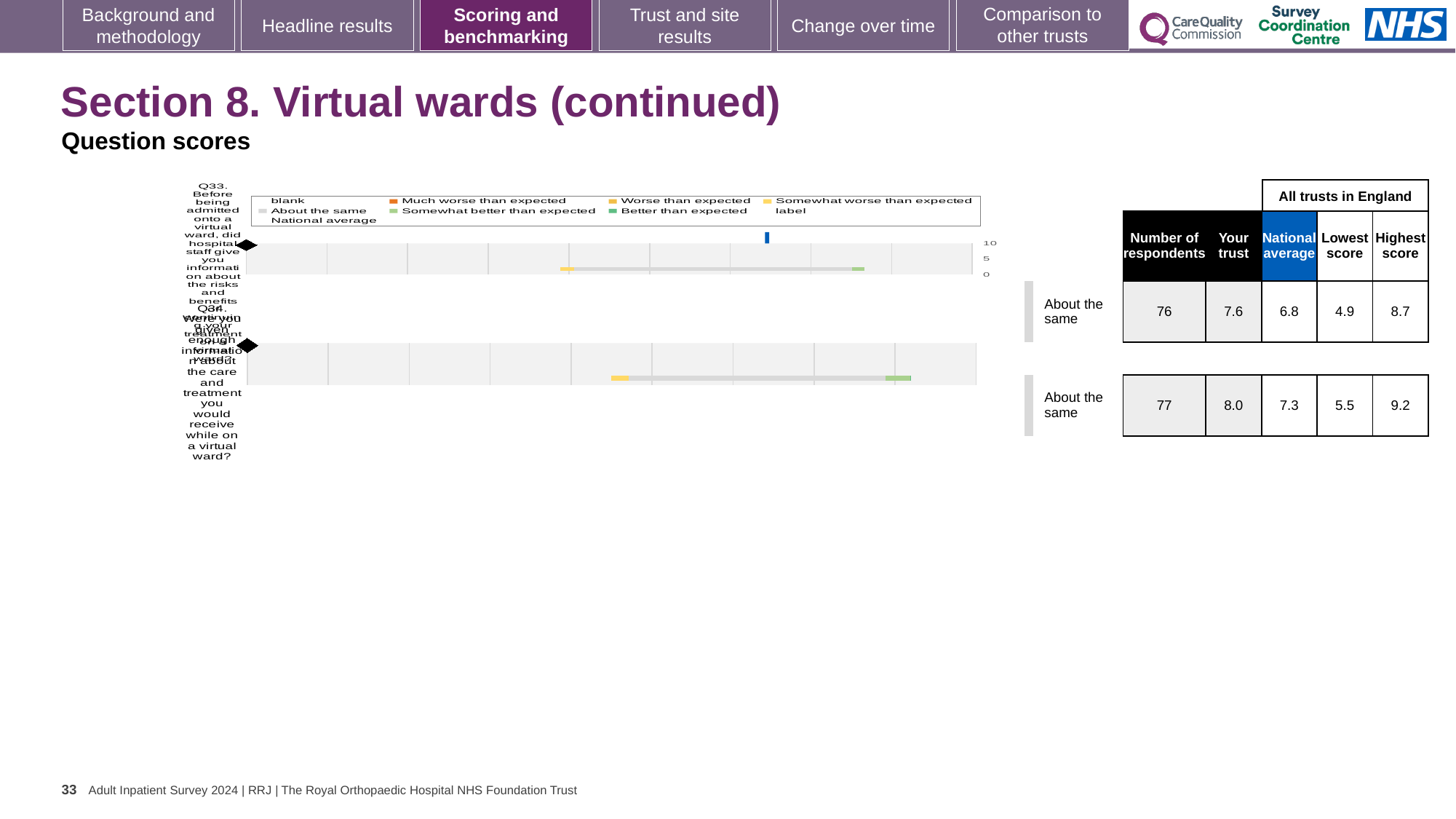
What kind of chart is used to show the question scores on this slide? bar chart How many questions are plotted in the chart? 2 What is the highest score among all trusts in England for Q34? 9.2 Is the 'Your trust' score for Q33 greater or less than 5? greater What is the difference between the 'Your trust' score and the national average for Q34? 0.7 What is the national average score for Q34? 7.3 What is the lowest score among all trusts in England for Q33? 4.9 How many respondents answered Q33? 76 What is the 'Your trust' score for Q33? 7.6 What colour does the legend use for 'Better than expected'? green Which question has the higher 'Your trust' score, Q33 or Q34? Q34 What benchmark category is shown for Q33? About the same